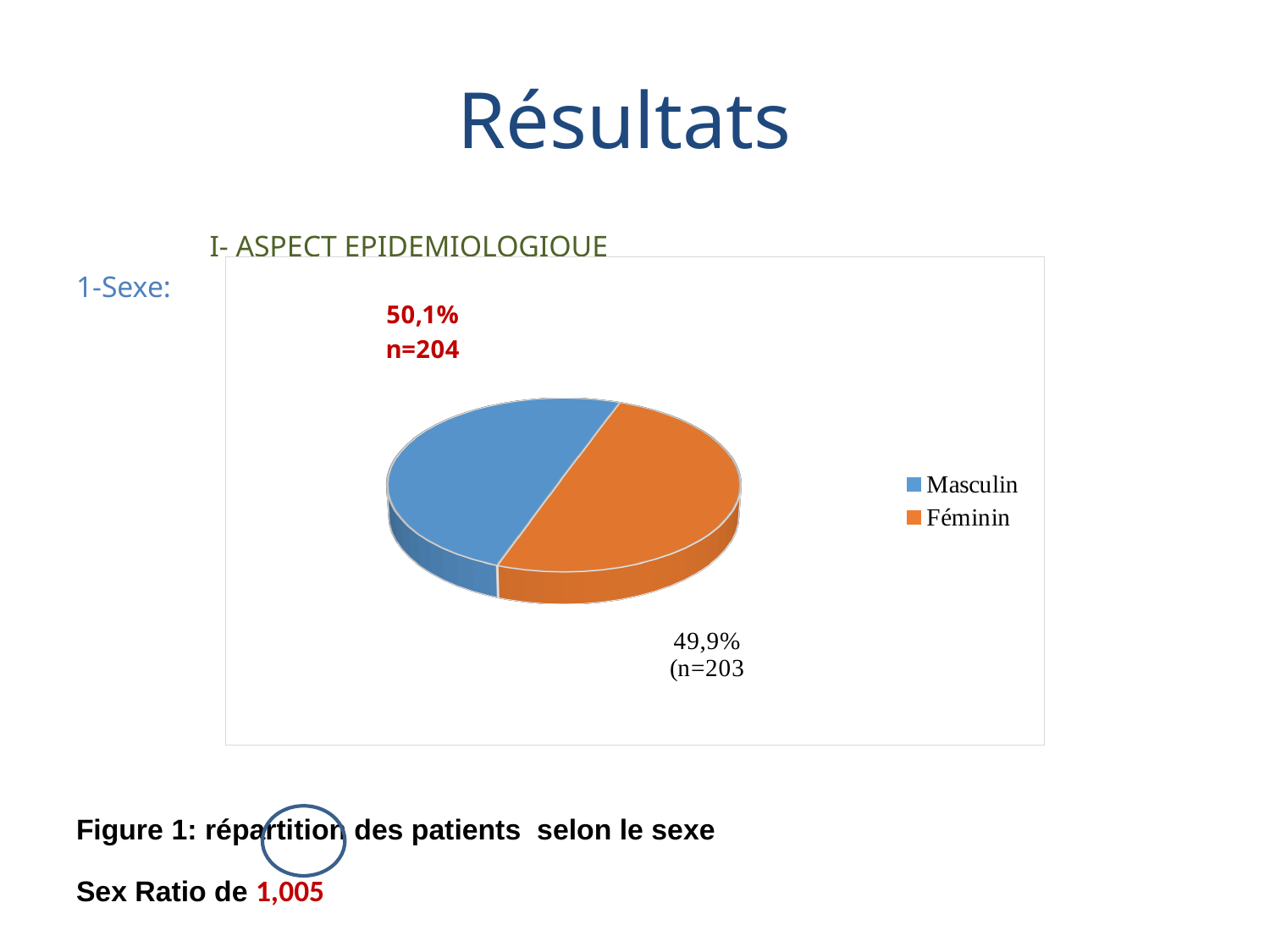
Which slice represents the larger share of patients, Masculin or Féminin? Masculin What are the two entries listed in the legend of the pie chart? Masculin and Féminin How many entries does the legend of the pie chart list? 2 What percentage is shown for the Féminin slice? 49,9% What share of the pie does the Féminin slice represent? 49,9% What is the difference in number of patients between the Masculin and Féminin slices? 1 What is the number of patients (n) for the Féminin slice? 203 What kind of chart is shown on the slide? Pie chart What is the total number of patients across both slices of the pie chart? 407 What percentage is shown for the Masculin slice? 50,1% What is the number of patients (n) for the Masculin slice? 204 How many slices does the pie chart have? 2